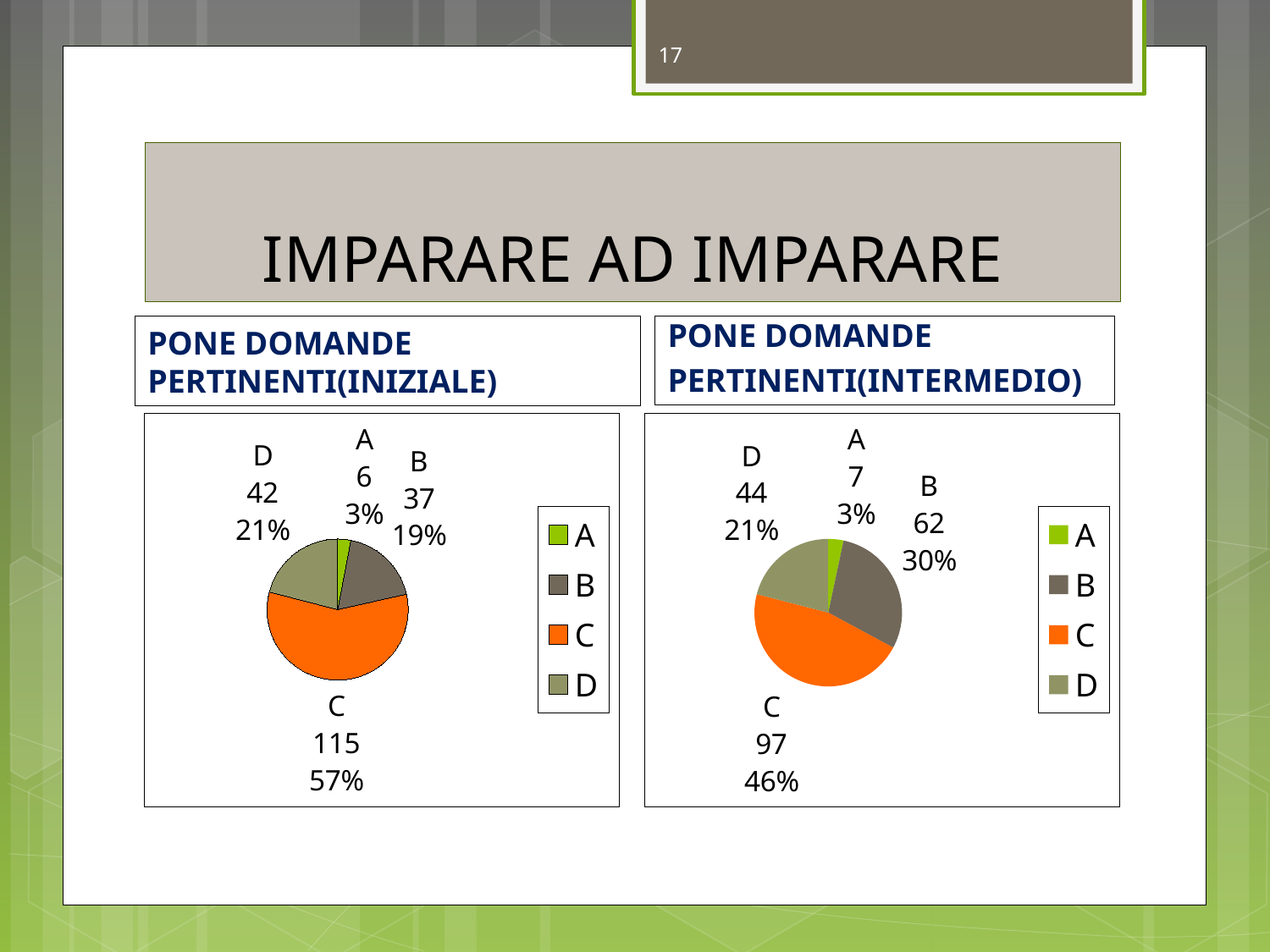
In the PONE DOMANDE PERTINENTI(INIZIALE) chart, what percentage share does D have? 21% In the PONE DOMANDE PERTINENTI(INIZIALE) chart, which category has the largest slice? C In the PONE DOMANDE PERTINENTI(INTERMEDIO) chart, which is larger, the value for B or the value for D? B What type of chart is the PONE DOMANDE PERTINENTI(INTERMEDIO) chart? Pie chart In the PONE DOMANDE PERTINENTI(INIZIALE) chart, what colour is the slice for C? Orange In the PONE DOMANDE PERTINENTI(INTERMEDIO) chart, what percentage share does C have? 46% In the PONE DOMANDE PERTINENTI(INTERMEDIO) chart, which category has the smallest slice? A In the PONE DOMANDE PERTINENTI(INIZIALE) chart, what is the difference between the values for C and B? 78 In the PONE DOMANDE PERTINENTI(INIZIALE) chart, what is the value for C? 115 How many categories does the PONE DOMANDE PERTINENTI(INIZIALE) chart show? 4 In the PONE DOMANDE PERTINENTI(INTERMEDIO) chart, what is the value for B? 62 In the PONE DOMANDE PERTINENTI(INTERMEDIO) chart, what is the total of all four values? 210